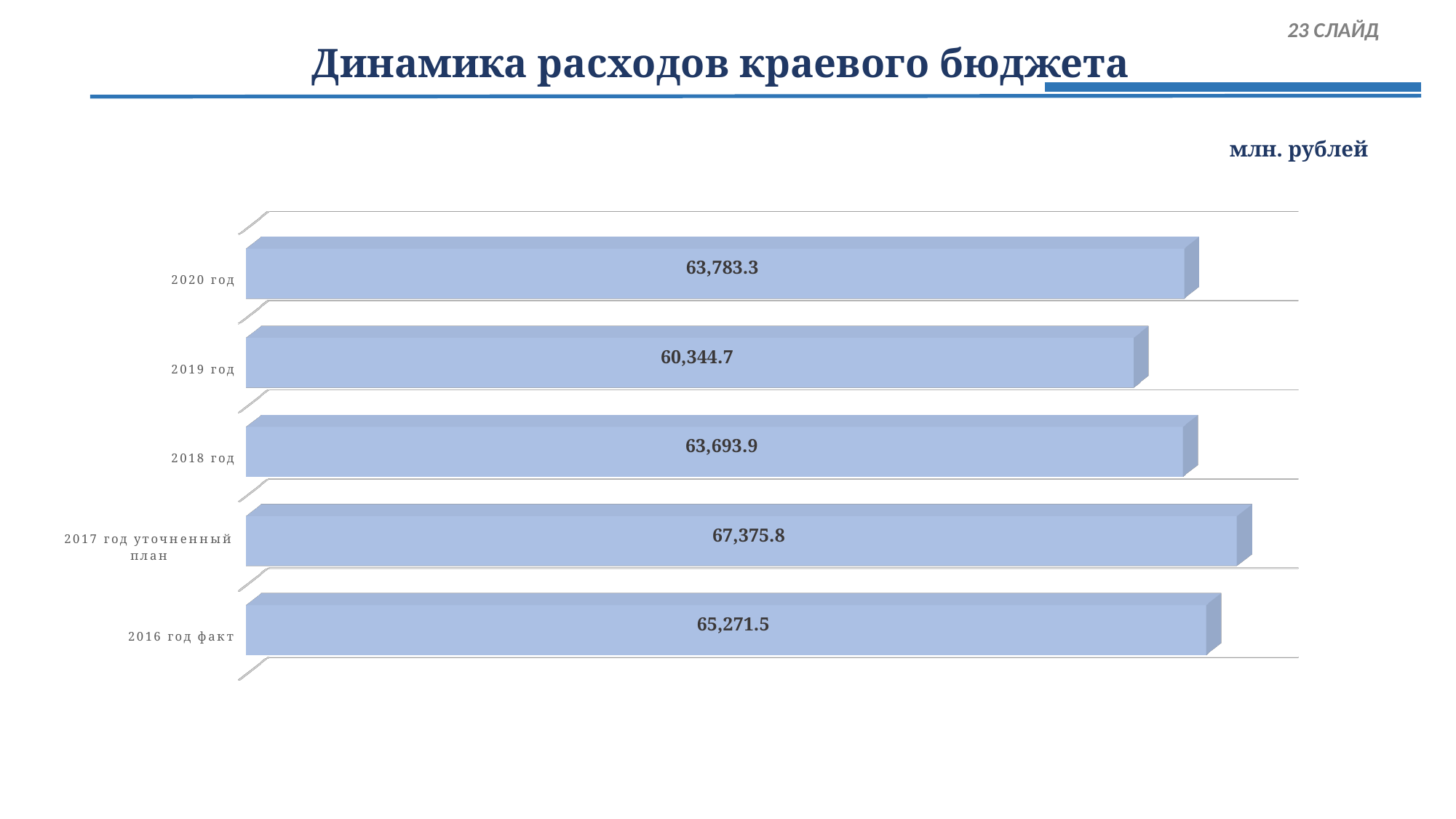
What is the value for 2020 год? 63,783.3 What is the difference between the values for 2018 год and 2019 год? 3,349.2 In what units are the chart values given? млн. рублей What is the difference between the values for 2017 год уточненный план and 2016 год факт? 2,104.3 What is the value for 2016 год факт? 65,271.5 Which is larger, the value for 2016 год факт or the value for 2019 год? 2016 год факт What is the value for 2019 год? 60,344.7 What is the value for 2017 год уточненный план? 67,375.8 Which category has the highest value? 2017 год уточненный план How many categories are shown in the chart? 5 Which category has the lowest value? 2019 год What type of chart is shown on the slide? Bar chart